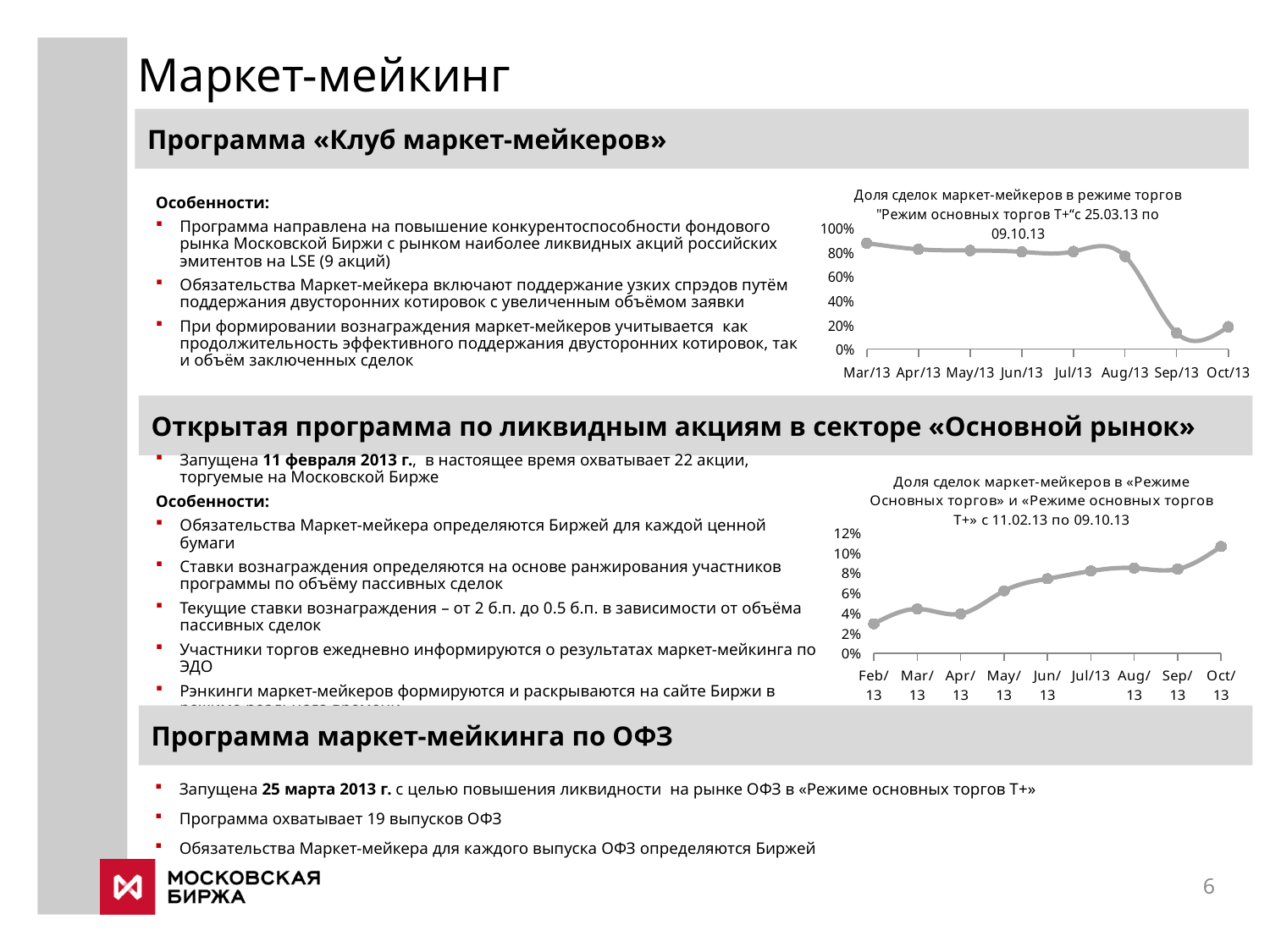
In the top chart (T+ mode from 25.03.13 to 09.10.13), is the value for Aug/13 greater or less than 60%? greater In the bottom chart (share of market-maker deals from 11.02.13 to 09.10.13), which month has the highest value? Oct/13 In the bottom chart (share of market-maker deals from 11.02.13 to 09.10.13), which month has the lowest value? Feb/13 In the top chart (T+ mode from 25.03.13 to 09.10.13), is the value for Mar/13 greater or less than 80%? greater In the bottom chart (share of market-maker deals from 11.02.13 to 09.10.13), is the value for Oct/13 greater or less than 10%? greater How many months are plotted on the x axis of the bottom chart (share of market-maker deals from 11.02.13 to 09.10.13)? 9 In the top chart (T+ mode from 25.03.13 to 09.10.13), do the values overall rise or fall from Mar/13 to Oct/13? fall How many months are plotted on the x axis of the top chart (T+ mode from 25.03.13 to 09.10.13)? 8 In the top chart (T+ mode from 25.03.13 to 09.10.13), which month has the lowest value? Sep/13 In the top chart (T+ mode from 25.03.13 to 09.10.13), which is larger, the value for Jul/13 or Sep/13? Jul/13 What kind of chart is the top chart on the slide (share of market-maker deals in T+ mode from 25.03.13)? line chart